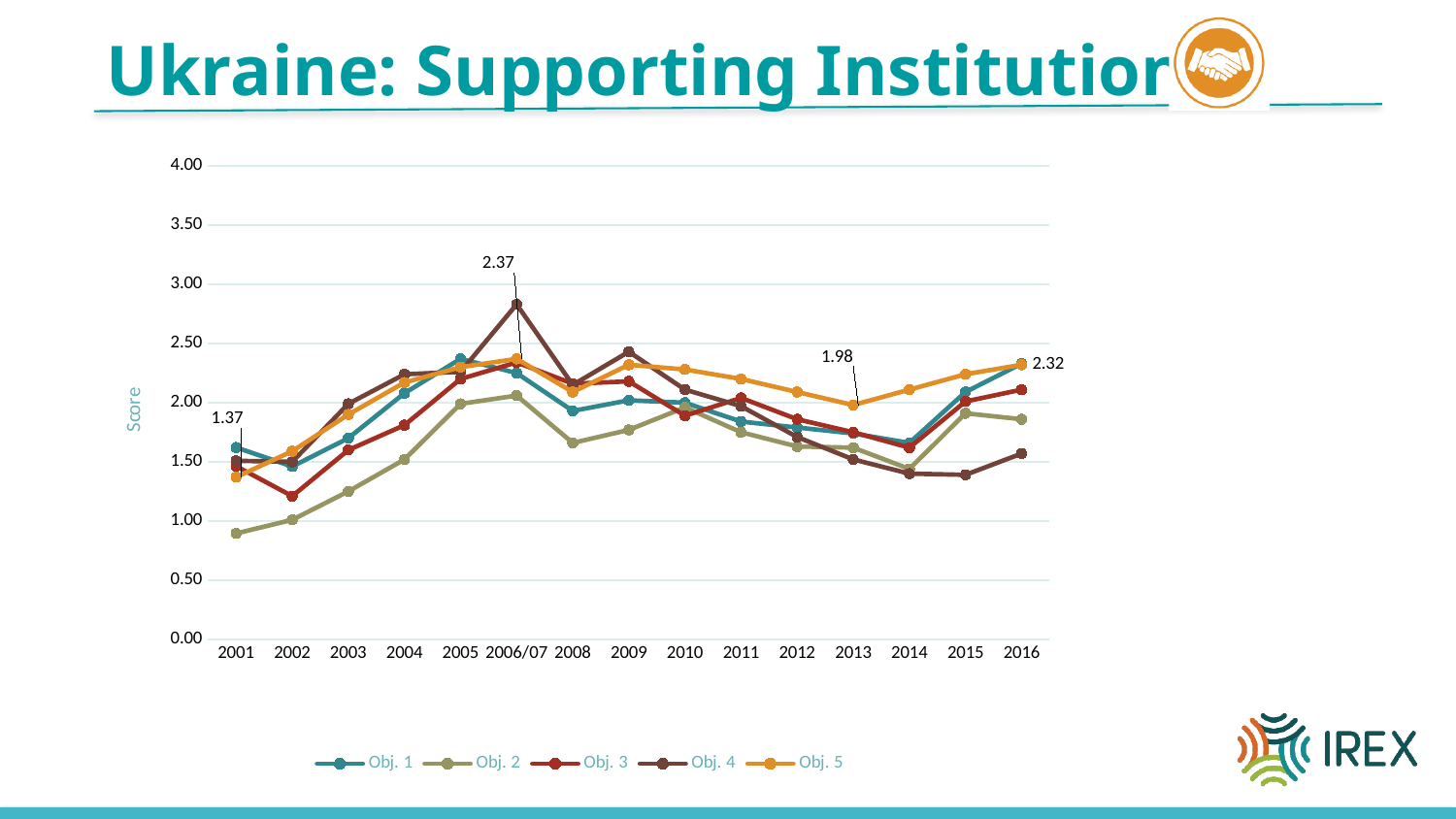
What is the label of the y axis? Score How many points are there along the x axis? 15 What is the value for Obj. 5 in 2013? 1.98 What is the value for Obj. 5 in 2001? 1.37 What kind of chart is shown on the slide? line chart What is the value for Obj. 5 in 2016? 2.32 What is the value for Obj. 5 in 2006/07? 2.37 Is the value for Obj. 2 in 2001 greater or less than 1.00? less How many series does the legend list? 5 Is the value for Obj. 4 in 2006/07 greater or less than 2.50? greater Which series has the lowest value in 2001? Obj. 2 By how much did the Obj. 5 value increase from 2013 to 2016? 0.34